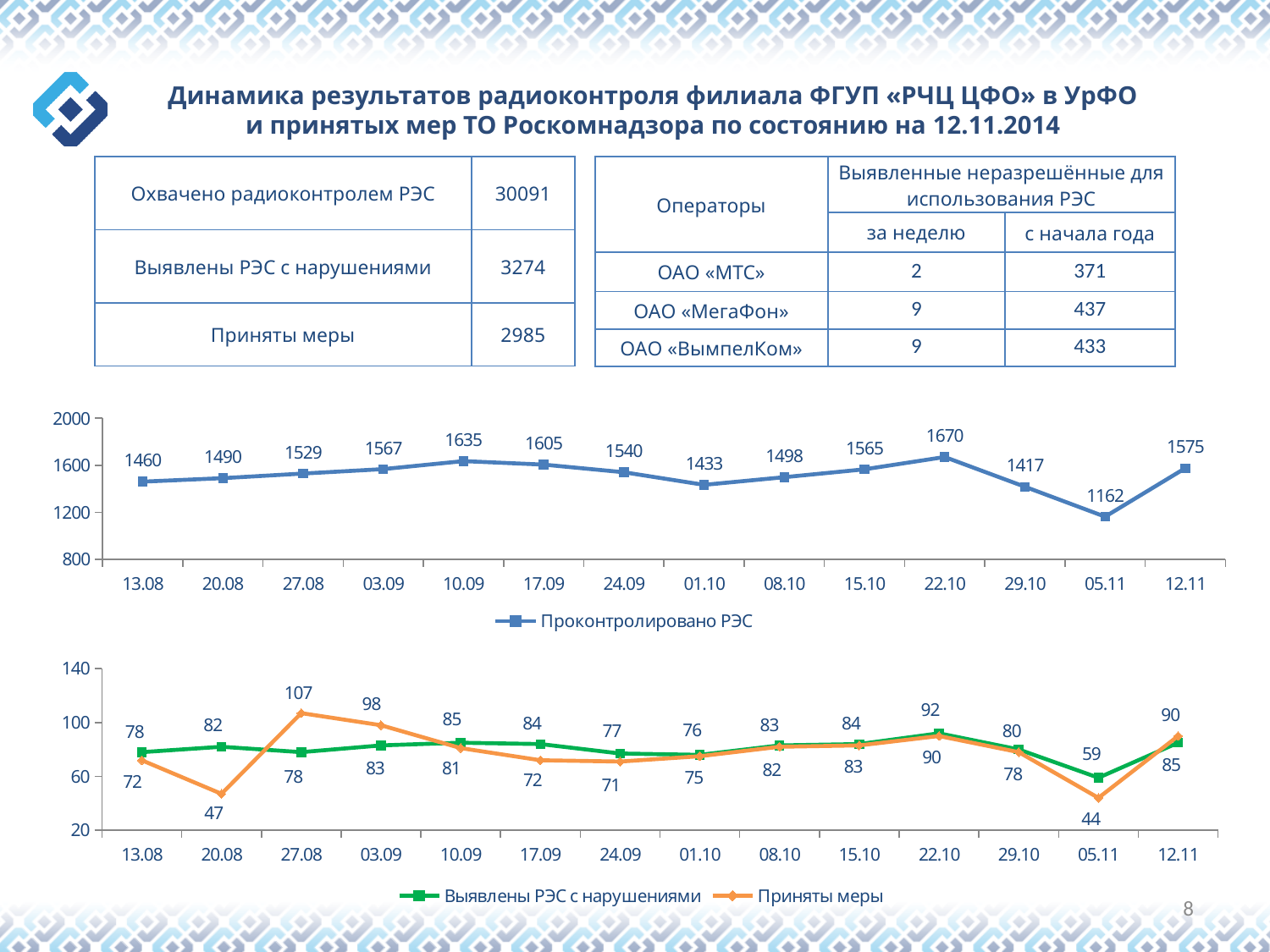
How many series does the legend of the bottom chart list? 2 In the top chart (Проконтролировано РЭС), how many data points are plotted? 14 In the bottom chart, what is the value of Выявлены РЭС с нарушениями for 05.11? 59 In the bottom chart, what is the value of Приняты меры for 27.08? 107 In the top chart (Проконтролировано РЭС), which date has the lowest value? 05.11 In the bottom chart, which is larger for 20.08: Выявлены РЭС с нарушениями or Приняты меры? Выявлены РЭС с нарушениями In the top chart (Проконтролировано РЭС), what is the difference between the values for 22.10 and 05.11? 508 In the bottom chart, which date has the lowest value for Приняты меры? 05.11 In the top chart (Проконтролировано РЭС), is the value for 10.09 greater or less than 1600? greater What type of chart is the top chart? line chart In the bottom chart, what is the difference between Приняты меры and Выявлены РЭС с нарушениями for 27.08? 29 In the top chart (Проконтролировано РЭС), what is the value for 22.10? 1670